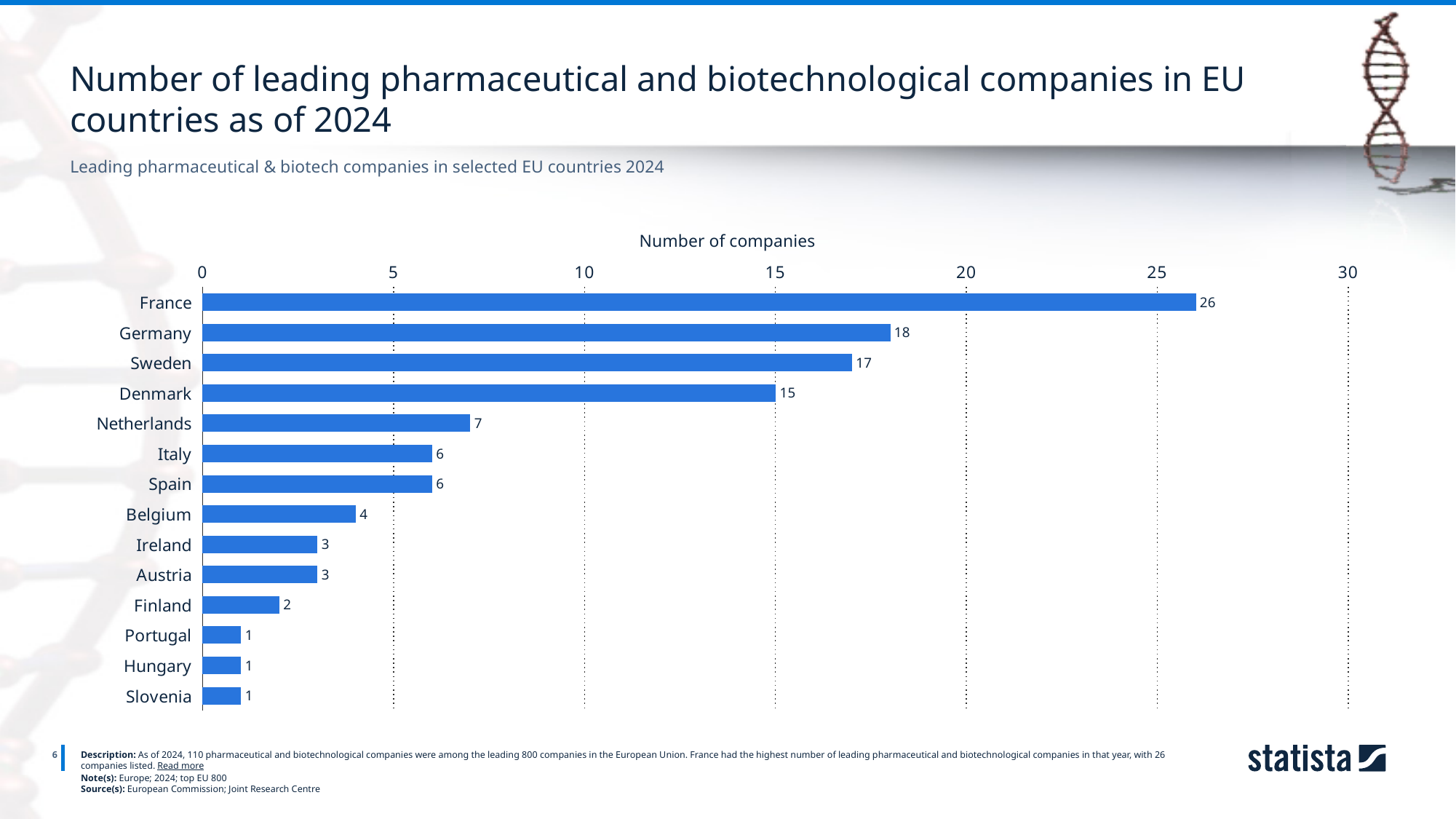
What is the label of the value axis? Number of companies What is the difference between France's and Denmark's values? 11 Is the value for Germany greater or less than 15? greater What type of chart is shown on the slide? Bar chart How many countries are shown in the chart? 14 What is the value shown for Belgium? 4 Which has more companies, the Netherlands or Italy? Netherlands What is the number of companies for Denmark? 15 How many countries have a value of 1? 3 Which country has the highest number of companies? France What is the difference between the number of companies in Germany and Sweden? 1 How many leading pharmaceutical and biotech companies does France have? 26